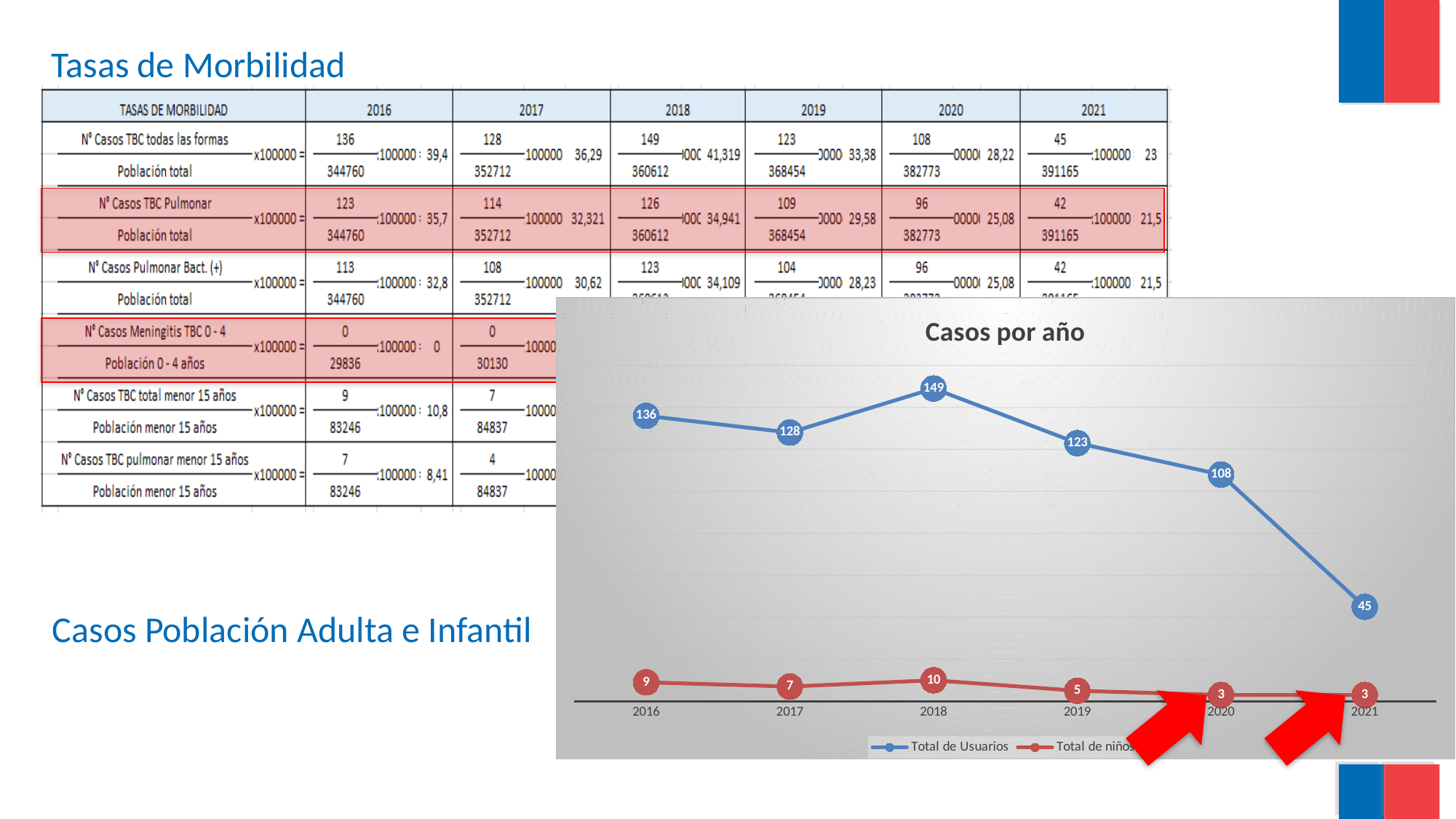
In the 'Casos por año' chart, what is the difference between Total de niños in 2018 and in 2019? 5 In the 'Casos por año' chart, which year has the highest value for Total de niños? 2018 How many series does the legend of the 'Casos por año' chart list? 2 In the 'Casos por año' chart, what is the difference between Total de Usuarios in 2020 and in 2021? 63 In the 'Casos por año' chart, what is the value of Total de niños in 2016? 9 In the 'Casos por año' chart, what is the value of Total de Usuarios in 2018? 149 In the 'Casos por año' chart, which is larger: Total de Usuarios in 2016 or in 2017? 2016 How many years are shown on the x axis of the 'Casos por año' chart? 6 In the 'Casos por año' chart, what is the value of Total de Usuarios in 2021? 45 In the 'Casos por año' chart, which year has the highest value for Total de Usuarios? 2018 In the 'Casos por año' chart, which year has the lowest value for Total de Usuarios? 2021 What type of chart is 'Casos por año'? Line chart